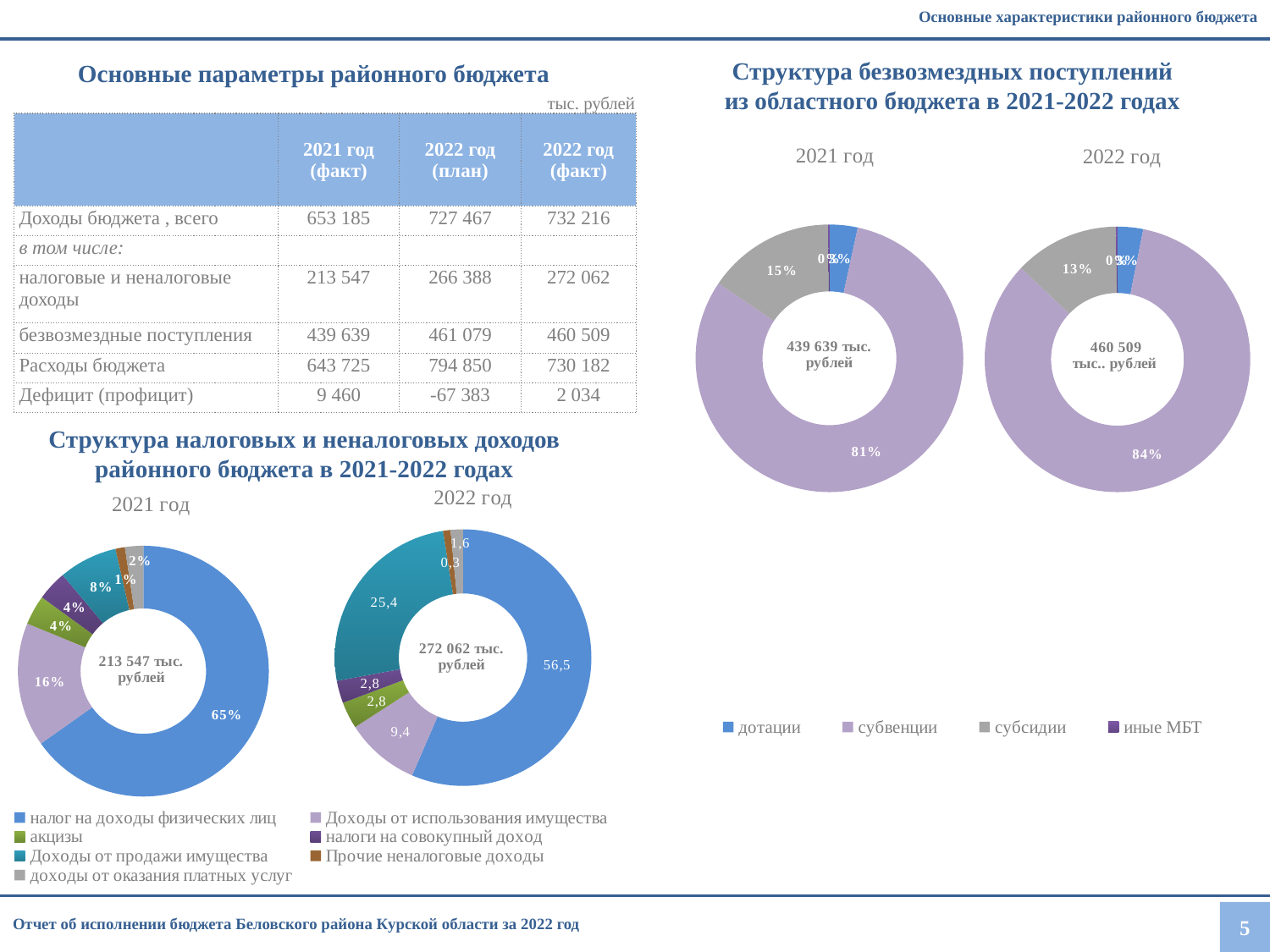
In the 2022 chart under 'Структура налоговых и неналоговых доходов', what value is shown for 'акцизы'? 2,8 What kind of chart is used for the 'Структура налоговых и неналоговых доходов районного бюджета в 2021-2022 годах' section? pie (doughnut) chart In the 2021 chart under 'Структура безвозмездных поступлений из областного бюджета', what share is shown for 'субсидии'? 15% In the 2021 chart under 'Структура налоговых и неналоговых доходов', what is the difference in percentage points between 'налог на доходы физических лиц' and 'Доходы от использования имущества'? 49 percentage points How many categories does the legend list for the 'Структура безвозмездных поступлений из областного бюджета' charts? 4 In the 2021 chart under 'Структура налоговых и неналоговых доходов', what share is shown for 'налог на доходы физических лиц'? 65% What total is printed in the centre of the 2022 chart under 'Структура налоговых и неналоговых доходов'? 272 062 тыс. рублей In the 2022 chart under 'Структура налоговых и неналоговых доходов', what value is shown for 'Доходы от продажи имущества'? 25,4 In the 2021 chart under 'Структура безвозмездных поступлений из областного бюджета', which category has the largest share? субвенции In the 2022 chart under 'Структура налоговых и неналоговых доходов', which is larger: 'Доходы от использования имущества' or 'Доходы от продажи имущества'? Доходы от продажи имущества In the 2022 chart under 'Структура безвозмездных поступлений из областного бюджета', what share is shown for 'субвенции'? 84% In the 2022 chart under 'Структура налоговых и неналоговых доходов', which category has the smallest share? Прочие неналоговые доходы